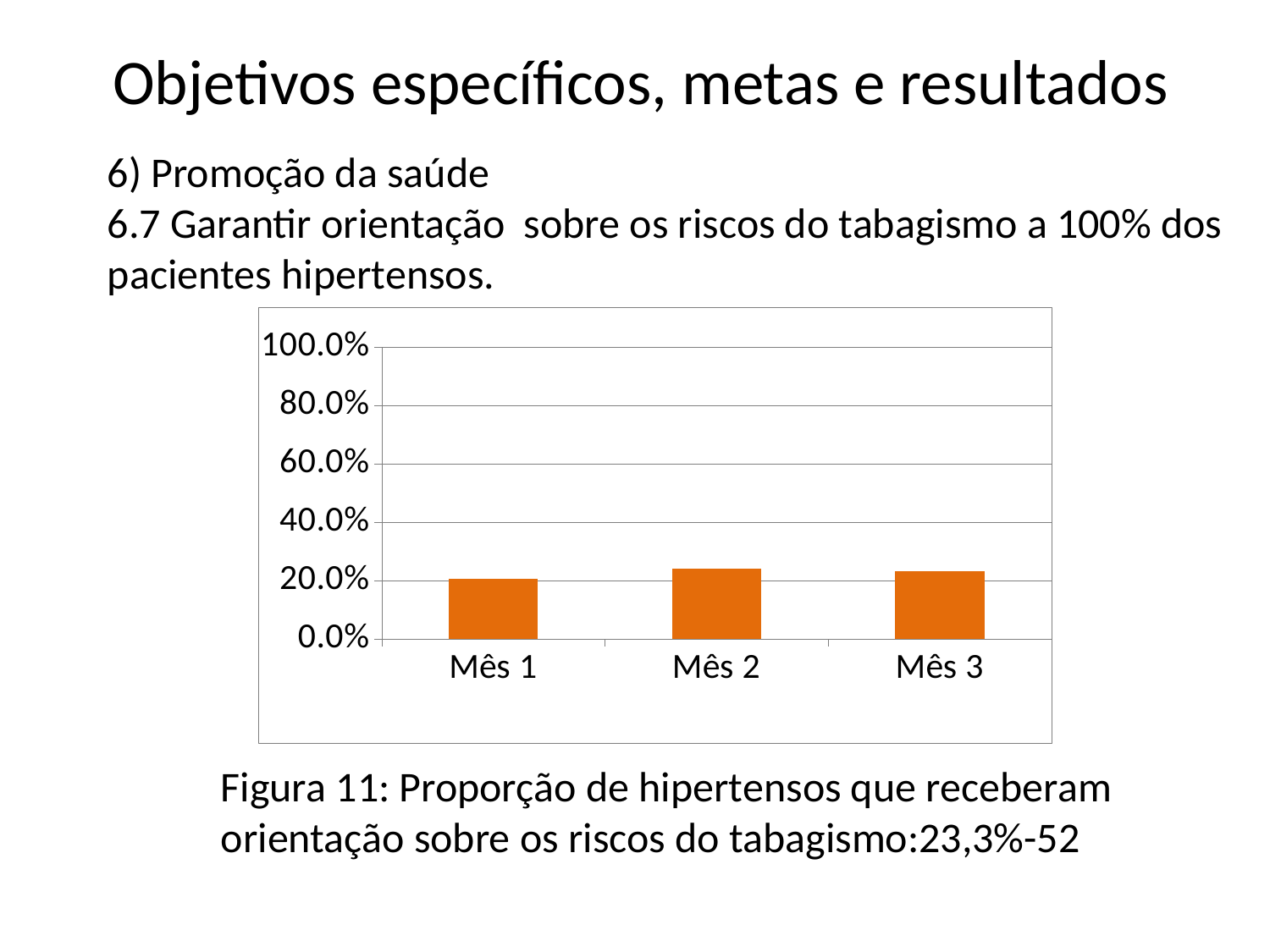
Does the value rise or fall from Mês 1 to Mês 2? rise What colour are the bars in the chart? orange Which is larger, the value for Mês 1 or the value for Mês 3? Mês 3 Is the value for Mês 1 greater or less than 60.0%? less Which month has the lowest bar on the chart? Mês 1 Is the value for Mês 2 greater or less than 20.0%? greater How many categories (months) are plotted on the chart? 3 Is the value for Mês 2 greater or less than 40.0%? less What kind of chart is shown on the slide? bar chart Which is larger, the value for Mês 1 or the value for Mês 2? Mês 2 What is the highest value shown on the vertical axis of the chart? 100.0%